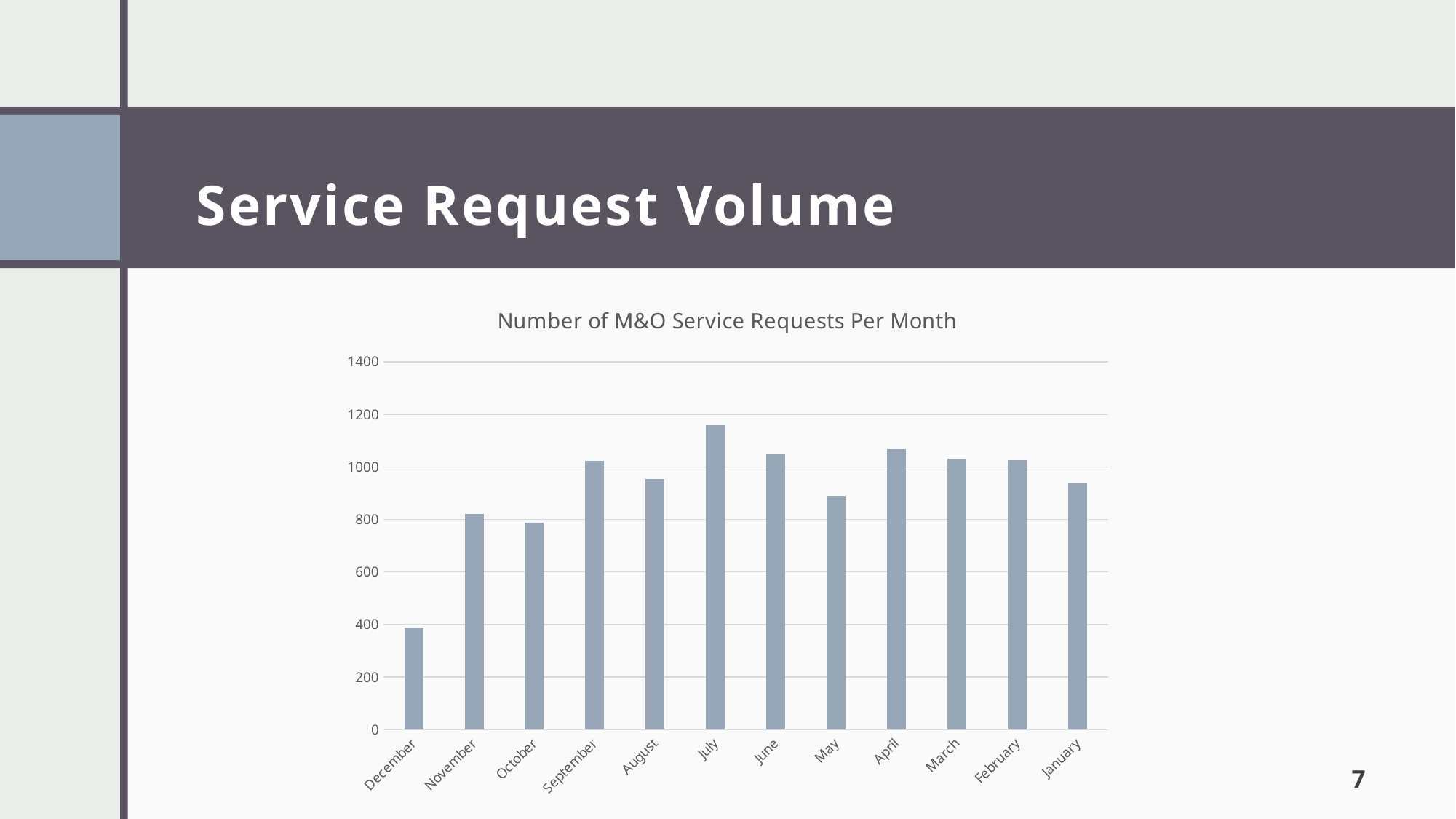
Is the value for July greater or less than 1000? greater Which is larger, the value for April or the value for May? April Is the value for November greater or less than 1000? less What is the title of the chart? Number of M&O Service Requests Per Month Is the value for December greater or less than 600? less Which month has the lowest number of service requests? December What kind of chart is shown on the slide? bar chart How many months are plotted on the chart? 12 Which month has the highest number of service requests? July Which is larger, the value for July or the value for December? July Which is larger, the value for June or the value for August? June